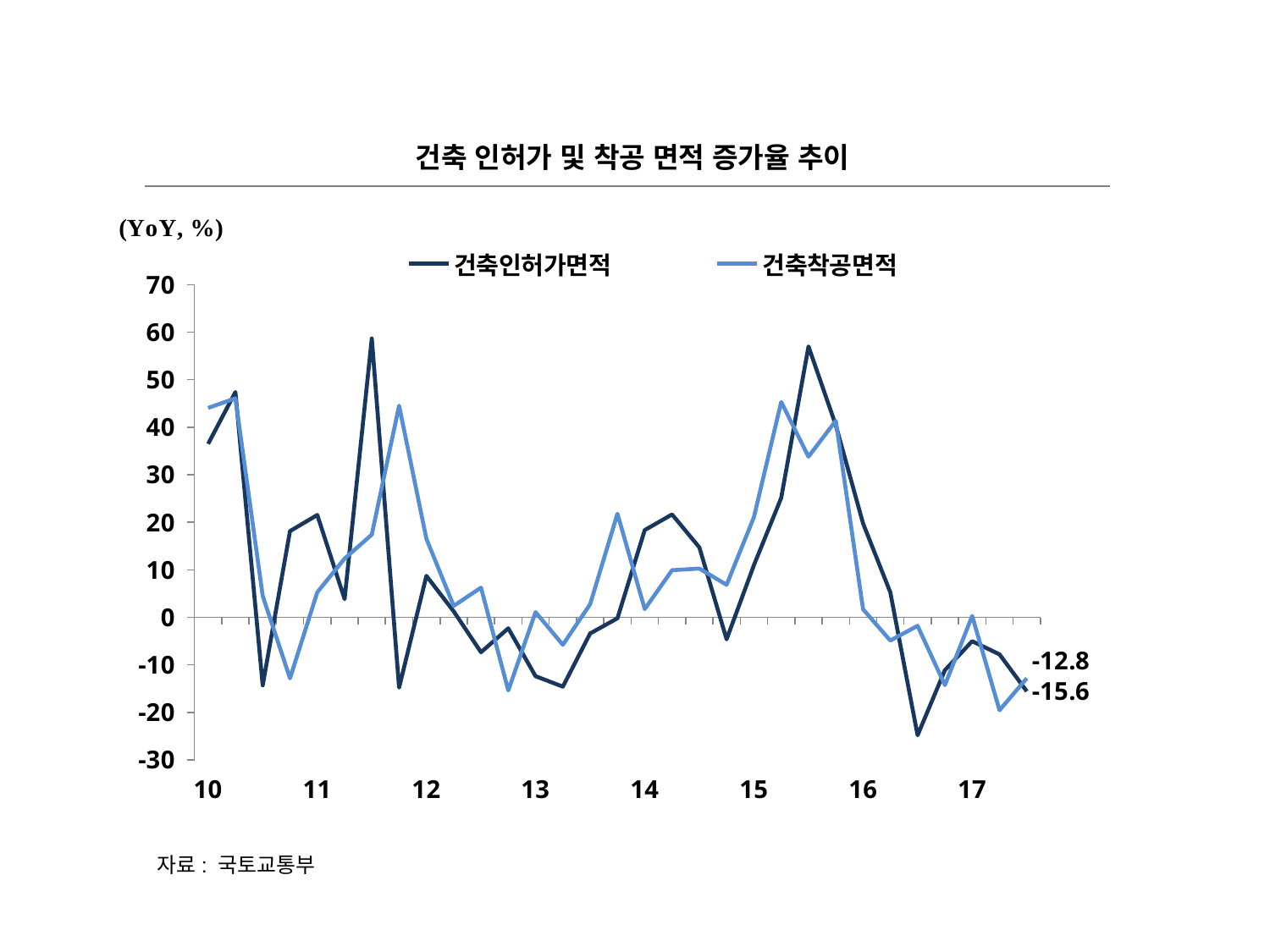
Is the peak value of 건축착공면적 around 2015 greater or less than 40? greater Is the lowest value of 건축인허가면적 around 2016 greater or less than -20? less What is the last labelled value for 건축착공면적 at the right end of the chart? -12.8 How many series does the legend list? 2 From the 2015 peak to the end of the chart in 2017, do the values of 건축인허가면적 rise or fall overall? fall What is the title of the chart? 건축 인허가 및 착공 면적 증가율 추이 What is the last labelled value for 건축인허가면적 at the right end of the chart? -15.6 At the right end of the chart, which series has the higher labelled value, 건축인허가면적 or 건축착공면적? 건축착공면적 What kind of chart is shown on the slide? line chart What are the two series named in the legend? 건축인허가면적, 건축착공면적 What is the difference between the two labelled end values, -12.8 and -15.6? 2.8 Is the peak value of 건축인허가면적 around 2011 greater or less than 50? greater